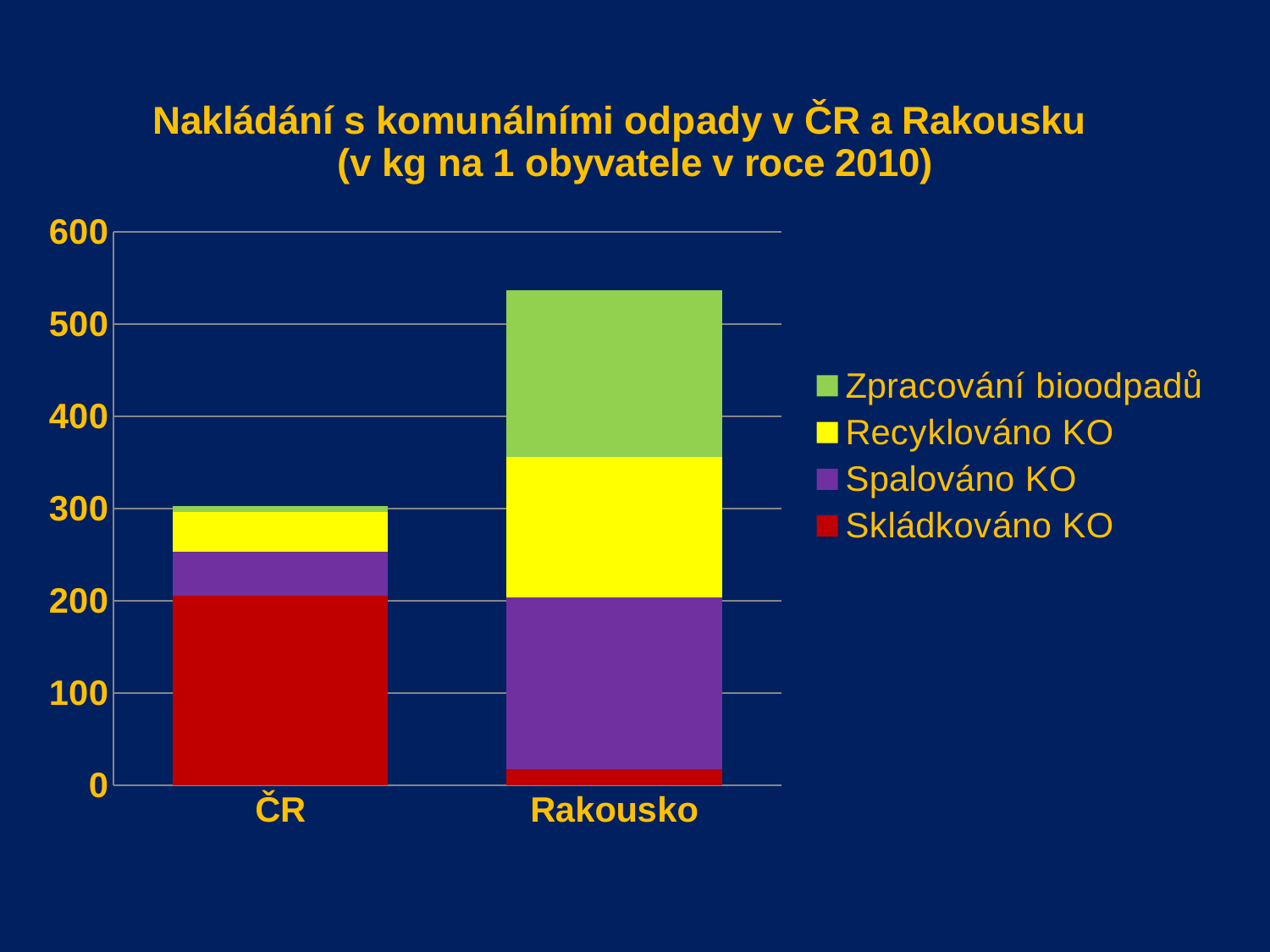
What kind of chart is shown on the slide? Stacked bar chart Is the total stacked bar for Rakousko greater or less than 500? greater How many series does the legend list? 4 Which country has the larger Zpracování bioodpadů segment? Rakousko Is the Skládkováno KO value for ČR greater or less than 100? greater What is the title of the chart? Nakládání s komunálními odpady v ČR a Rakousku (v kg na 1 obyvatele v roce 2010) Which country has the taller total stacked bar, ČR or Rakousko? Rakousko Is the total stacked bar for ČR greater or less than 400? less Which country has the larger Skládkováno KO segment? ČR How many countries (categories) are shown on the x axis? 2 Which colour represents Skládkováno KO in the legend? Red